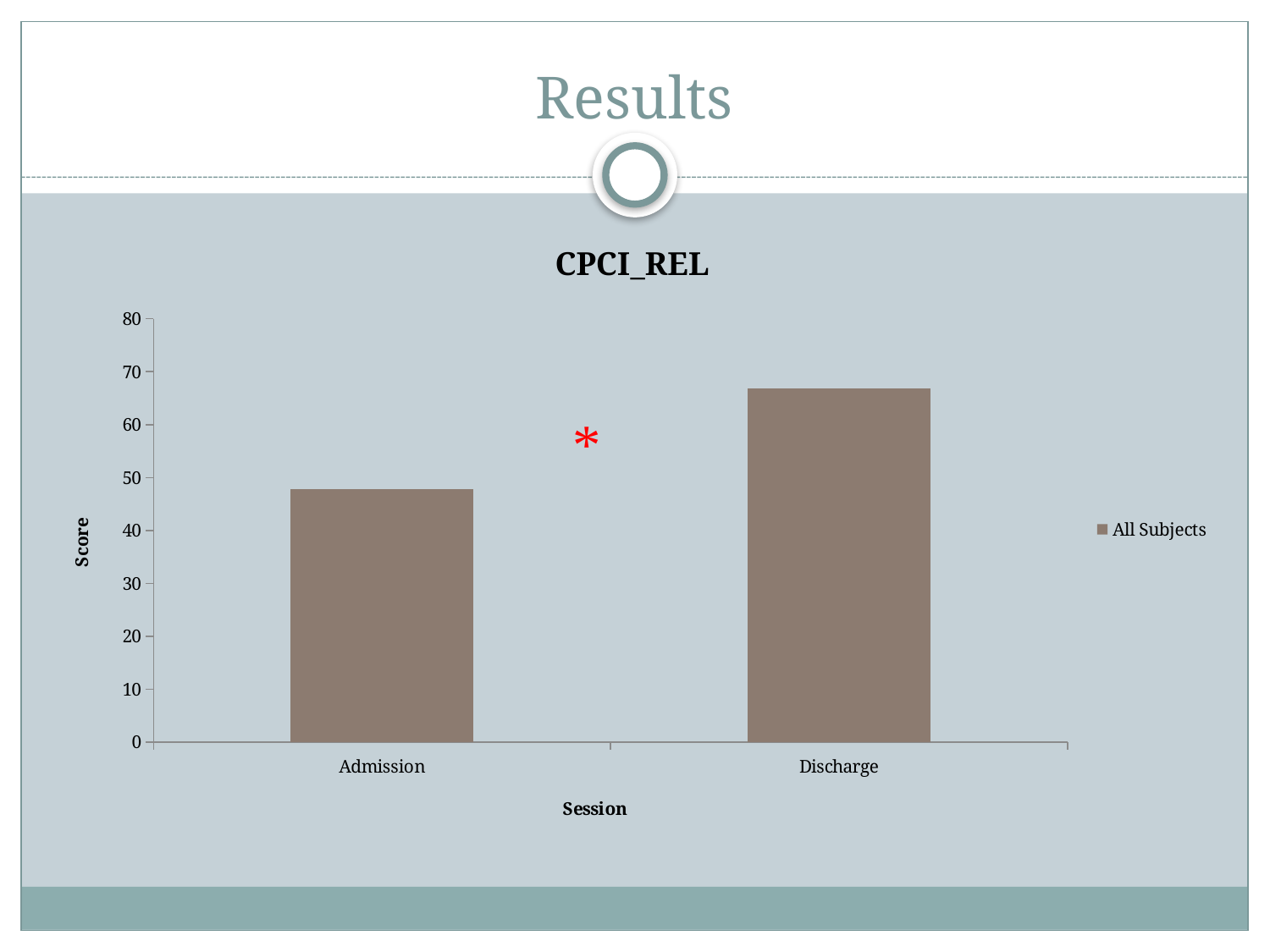
How many series does the legend list? 1 Is the score for Admission greater or less than 50? less Is the score for Discharge greater or less than 60? greater Which session has the highest score? Discharge Is the score for Discharge greater or less than 70? less What type of chart is shown on the slide? bar chart Which session has the lowest score? Admission Do the scores rise or fall from Admission to Discharge? rise What is the name of the series in the legend? All Subjects How many categories are shown on the x axis? 2 What is the title of the chart? CPCI_REL